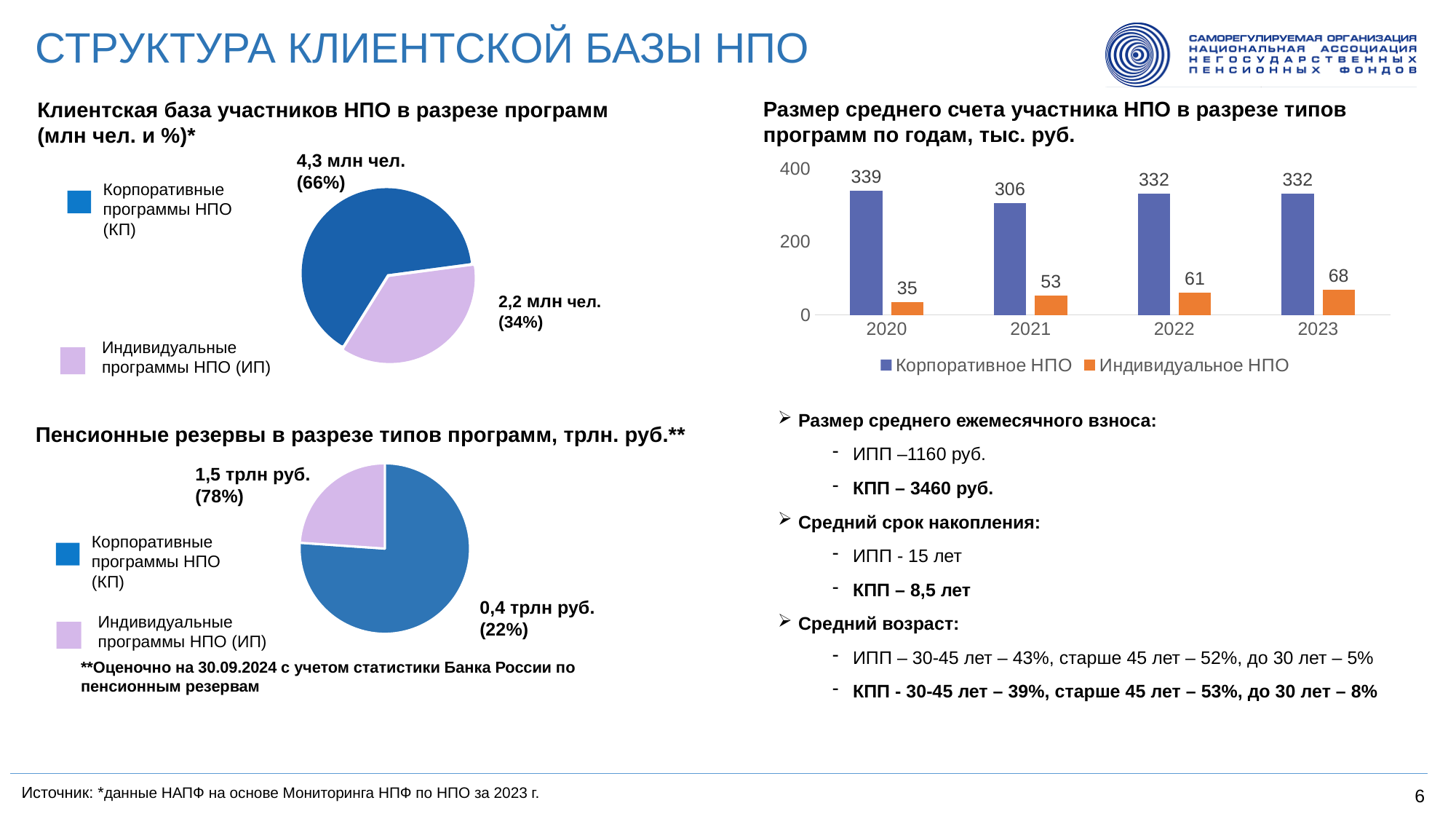
How many years are shown on the x axis of the bar chart on the right? 4 In the bar chart on the right, what is the value for Индивидуальное НПО in 2023? 68 In the bar chart on the right, do the values for Индивидуальное НПО rise or fall from 2020 to 2023? rise In the bar chart on the right, in which year is the value for Корпоративное НПО lowest? 2021 In the bar chart 'Размер среднего счета участника НПО в разрезе типов программ по годам, тыс. руб.', what is the value for Корпоративное НПО in 2020? 339 In the pie chart 'Клиентская база участников НПО в разрезе программ', what share do Индивидуальные программы НПО (ИП) have? 34% In the pie chart 'Клиентская база участников НПО в разрезе программ', what is the value for Корпоративные программы НПО (КП)? 4,3 млн чел. How many series does the legend of the bar chart on the right list? 2 In the bar chart on the right, in which year is the value for Индивидуальное НПО highest? 2023 What kind of chart is 'Размер среднего счета участника НПО в разрезе типов программ по годам'? bar chart In the bar chart on the right, which is larger for Корпоративное НПО: the value in 2020 or in 2021? 2020 In the bar chart on the right, what is the difference between Корпоративное НПО and Индивидуальное НПО in 2021? 253